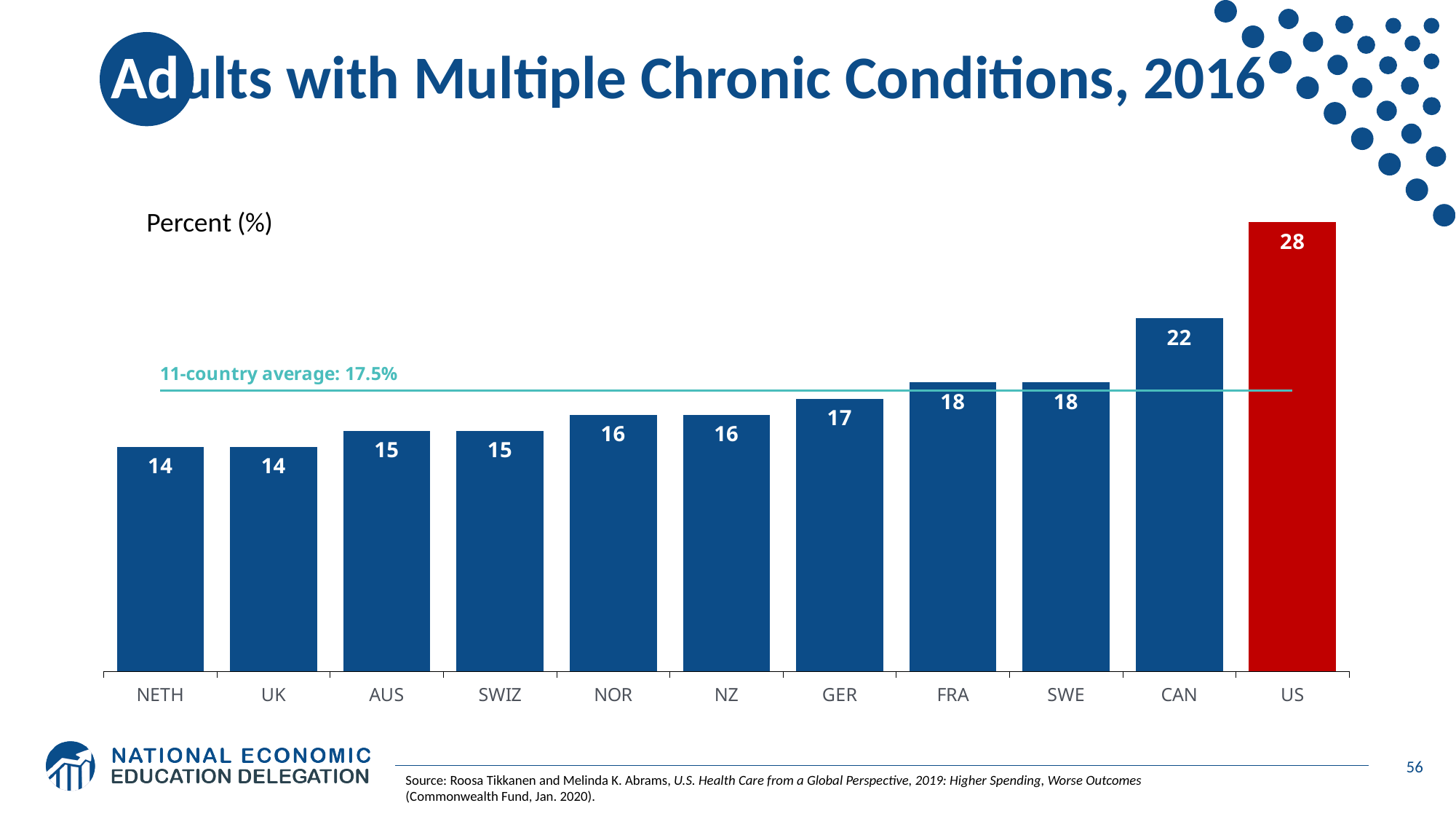
Do the values rise or fall moving from left to right along the x axis? Rise Which has a larger value, NOR or SWE? SWE What is the difference between the values for the US and CAN? 6 What is the value for the US? 28 Which bar is coloured red? US Which country has the highest value? US What kind of chart is shown on the slide? Bar chart What is the value for GER? 17 What is the difference between the values for FRA and NETH? 4 How many countries are shown on the chart? 11 What is the value for CAN? 22 What is the 11-country average shown on the chart? 17.5%